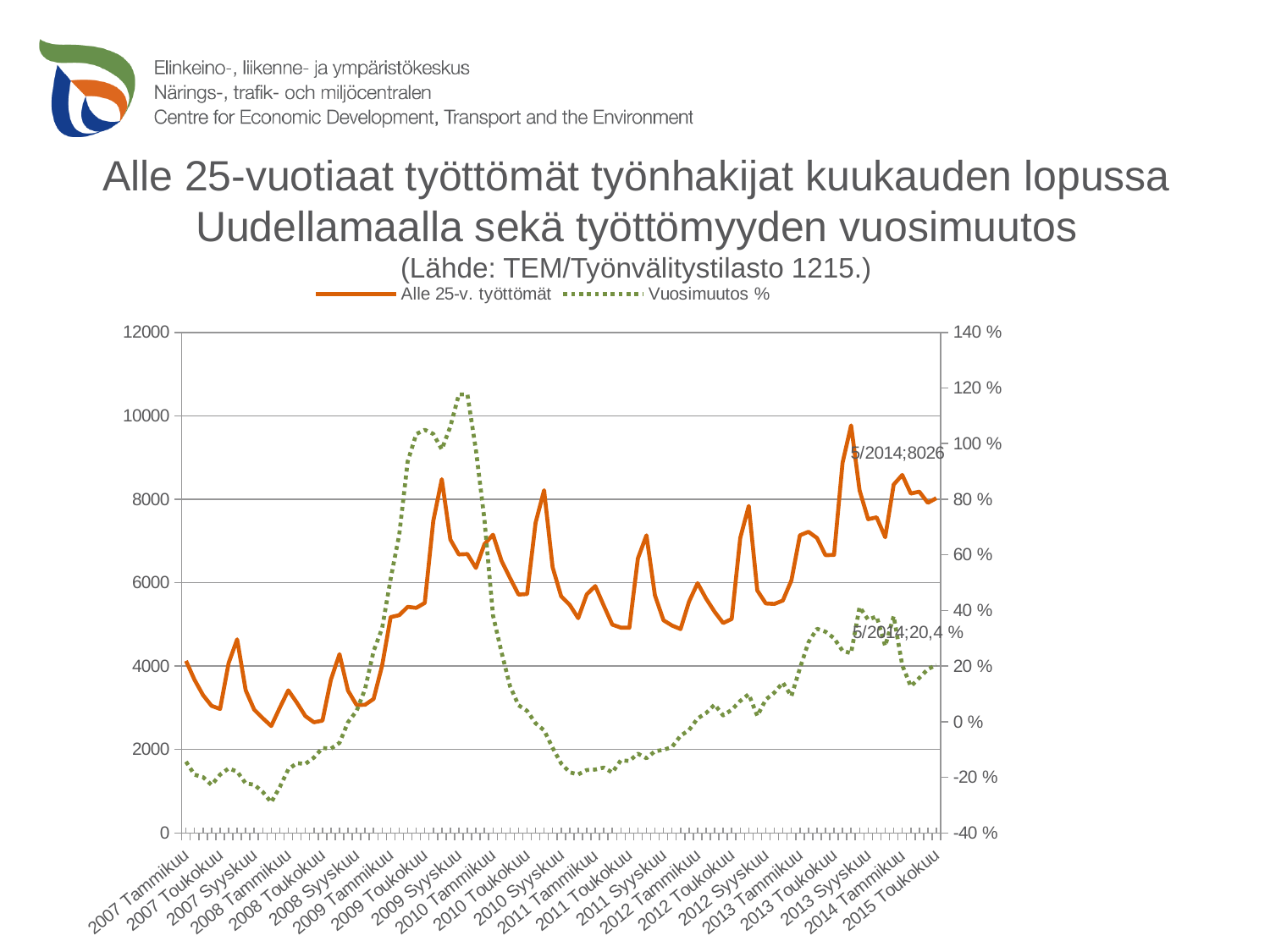
What is the maximum value shown on the left vertical axis? 12000 Is the highest value reached by the Vuosimuutos % series greater or less than 100 %? greater What are the two series named in the legend? Alle 25-v. työttömät and Vuosimuutos % What kind of chart is shown on the slide? line chart Is the value of Alle 25-v. työttömät at 2008 Tammikuu greater or less than 4000? less What is the value of Vuosimuutos % at 5/2014 according to the data label? 20,4 % What is the value of Alle 25-v. työttömät at 5/2014 according to the data label? 8026 Which is higher for Alle 25-v. työttömät: the value at 2009 Toukokuu or at 2007 Toukokuu? 2009 Toukokuu How many series does the legend list? 2 Overall, does the Alle 25-v. työttömät series rise or fall from 2007 Tammikuu to 2015 Toukokuu? rise Is the value of Alle 25-v. työttömät at 2007 Tammikuu greater or less than 6000? less